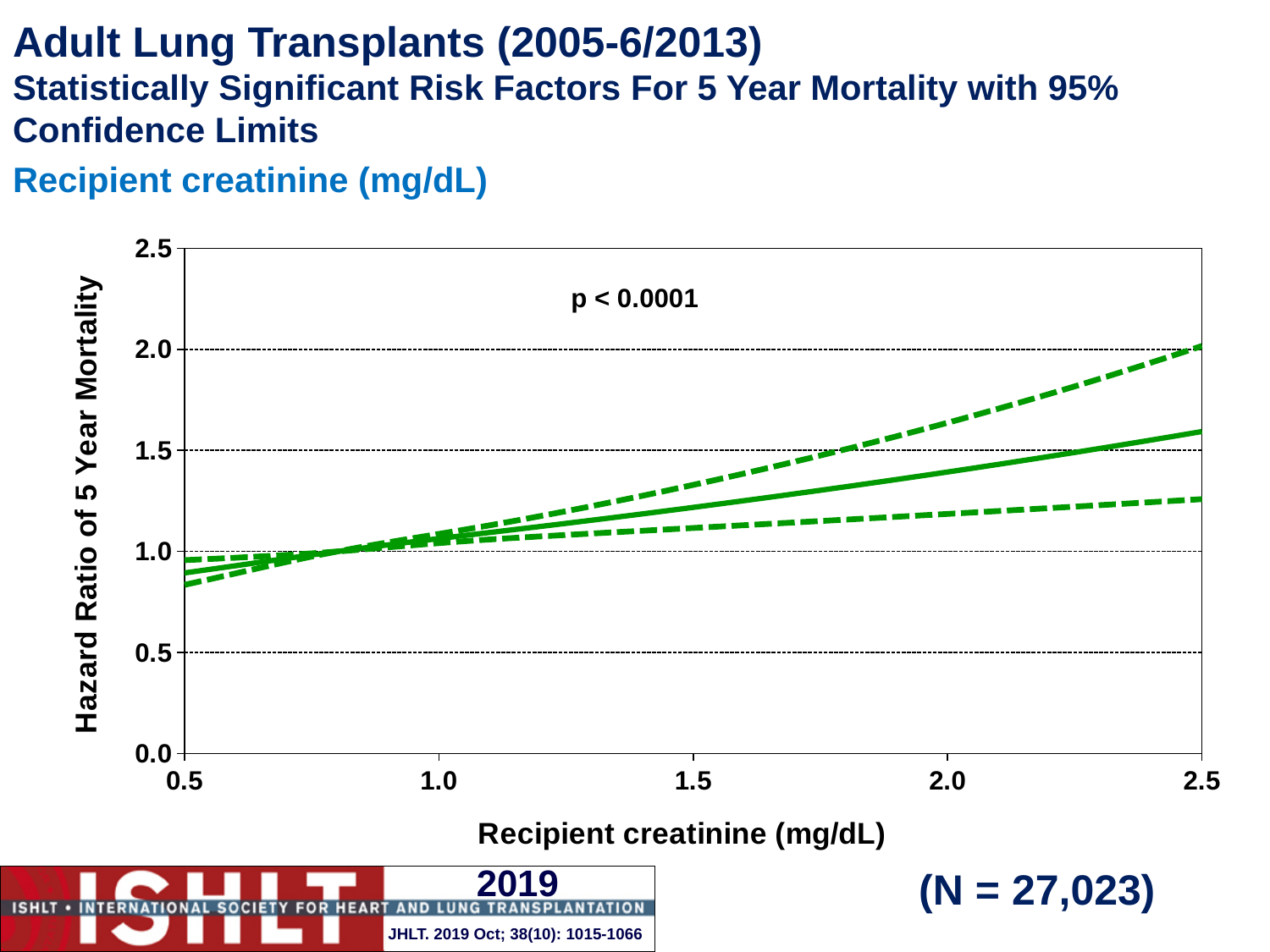
Is the value of the solid hazard ratio line at a recipient creatinine of 0.5 mg/dL greater or less than 1.0? less Is the value of the solid hazard ratio line at a recipient creatinine of 1.5 mg/dL greater or less than 1.5? less What kind of chart is shown on the slide? line chart How many lines are plotted on the chart? 3 Is the value of the solid hazard ratio line at a recipient creatinine of 2.5 mg/dL greater or less than 1.5? greater Does the hazard ratio of 5 year mortality rise or fall as recipient creatinine increases along the x axis? rise What is the label of the y axis of the chart? Hazard Ratio of 5 Year Mortality What p-value is printed on the chart? p < 0.0001